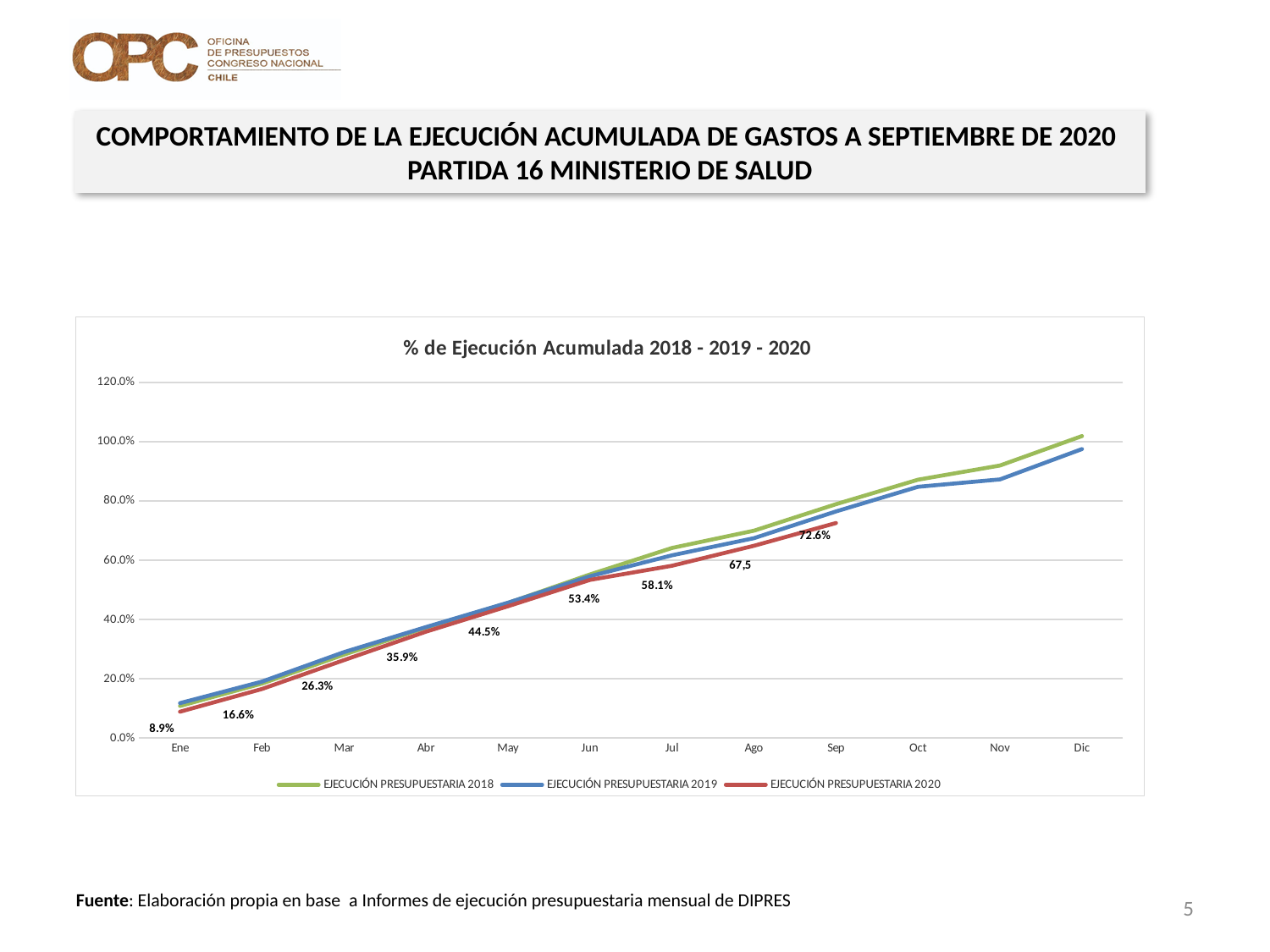
What is the value for EJECUCIÓN PRESUPUESTARIA 2020 in Jun? 53.4% What is the value for EJECUCIÓN PRESUPUESTARIA 2020 in Sep? 72.6% What is the value for EJECUCIÓN PRESUPUESTARIA 2020 in Mar? 26.3% Which month has the lowest value for EJECUCIÓN PRESUPUESTARIA 2020? Ene Is the value for EJECUCIÓN PRESUPUESTARIA 2018 in Dic greater or less than 80.0%? greater What type of chart is shown on the slide? line chart How many series does the legend list? 3 What is the chart's title? % de Ejecución Acumulada 2018 - 2019 - 2020 What is the value for EJECUCIÓN PRESUPUESTARIA 2020 in Ene? 8.9% What is the difference between the EJECUCIÓN PRESUPUESTARIA 2020 values for May and Abr? 8.6% How many months are shown on the x axis? 12 Does the EJECUCIÓN PRESUPUESTARIA 2020 line rise or fall from Ene to Sep? rise